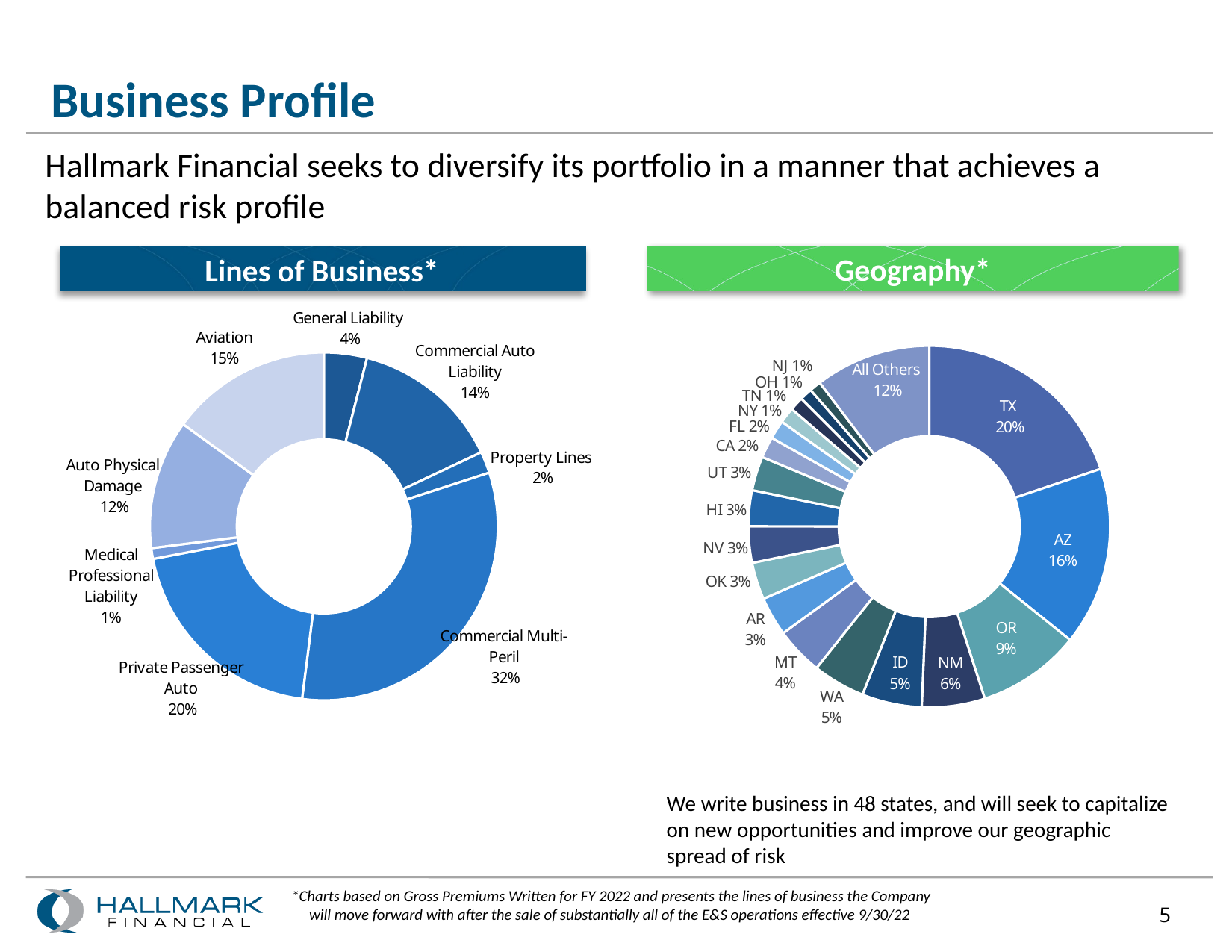
In the Lines of Business chart, which line of business has the smallest share? Medical Professional Liability How many lines of business are shown in the Lines of Business chart? 8 In the Geography chart, which named state has the largest share? TX In the Lines of Business chart, what share does Commercial Multi-Peril represent? 32% In the Lines of Business chart, which line of business has the largest share? Commercial Multi-Peril In the Geography chart, what is the difference in percentage points between AZ and OR? 7 In the Geography chart, what share does TX represent? 20% In the Lines of Business chart, what is the difference in percentage points between Private Passenger Auto and Aviation? 5 In the Lines of Business chart, which is larger: Commercial Auto Liability or Auto Physical Damage? Commercial Auto Liability In the Geography chart, what share does All Others represent? 12% In the Geography chart, which is larger: NM or MT? NM What type of chart is the Geography chart? Donut chart